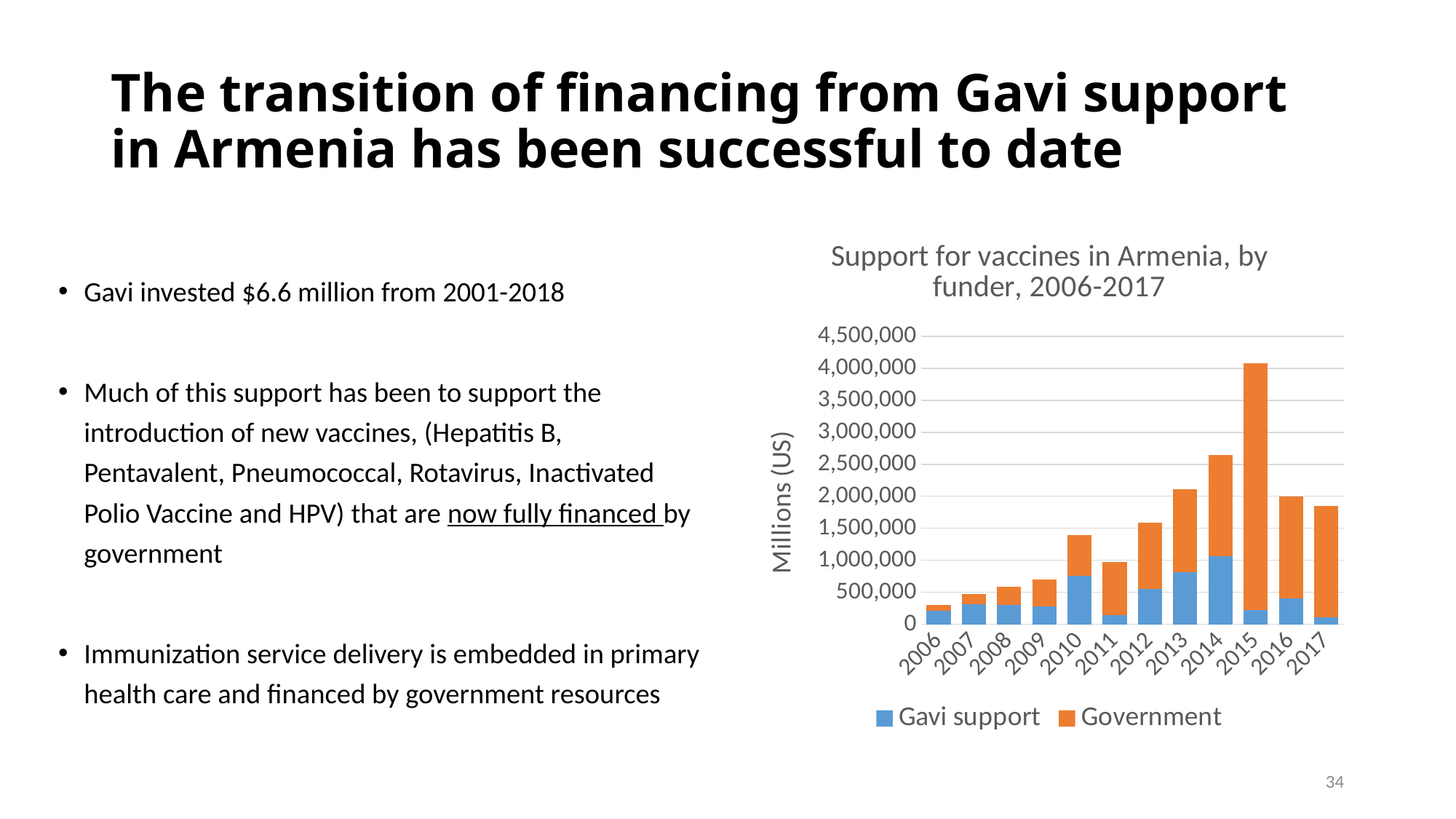
What kind of chart is shown on the slide? Stacked bar chart How many years are shown on the x axis of the chart? 12 Which year has the lowest total support for vaccines in Armenia? 2006 Is the total value for 2015 greater or less than 3,500,000? greater Do the total values rise or fall from 2006 to 2010? rise Is the total value for 2010 greater or less than 1,500,000? less Which year has the largest Gavi support? 2014 Which year has a larger total, 2013 or 2014? 2014 What is the label on the y axis of the chart? Millions (US) How many series does the chart's legend list? 2 Is the Gavi support value for 2010 greater or less than 500,000? greater Which year has the highest total support for vaccines in Armenia? 2015